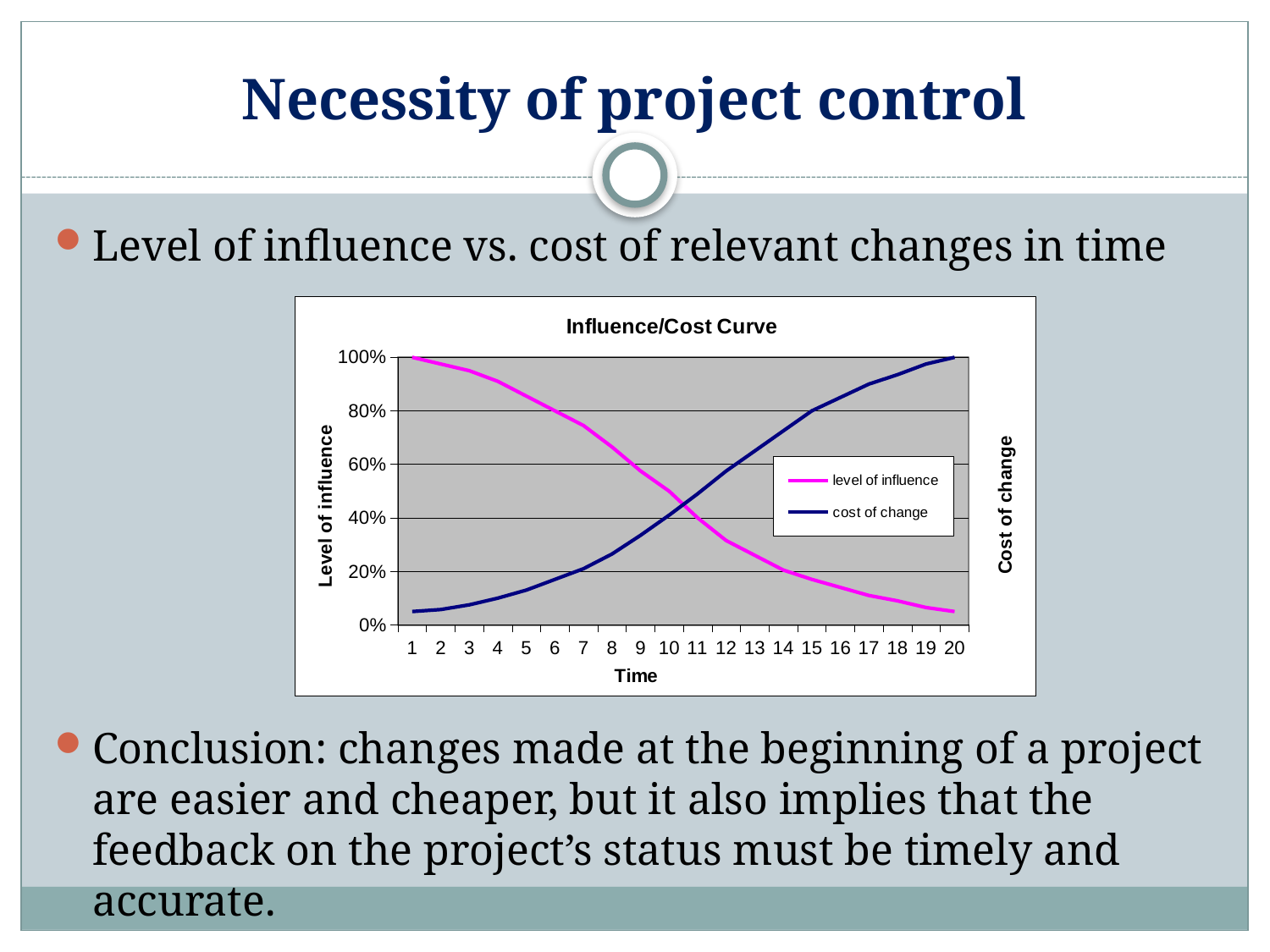
At which time is the level of influence highest? 1 How many series does the legend of the Influence/Cost Curve chart list? 2 What is the title of the chart? Influence/Cost Curve What is the label of the x axis of the chart? Time Is the cost of change at time 5 greater or less than 20%? less How many time points are shown on the x axis of the chart? 20 What is the level of influence at time 1? 100% Does the cost of change series rise or fall as time increases? rise What kind of chart is shown on the slide? line chart What is the cost of change at time 20? 100% Does the level of influence series rise or fall as time increases? fall At which time is the cost of change lowest? 1